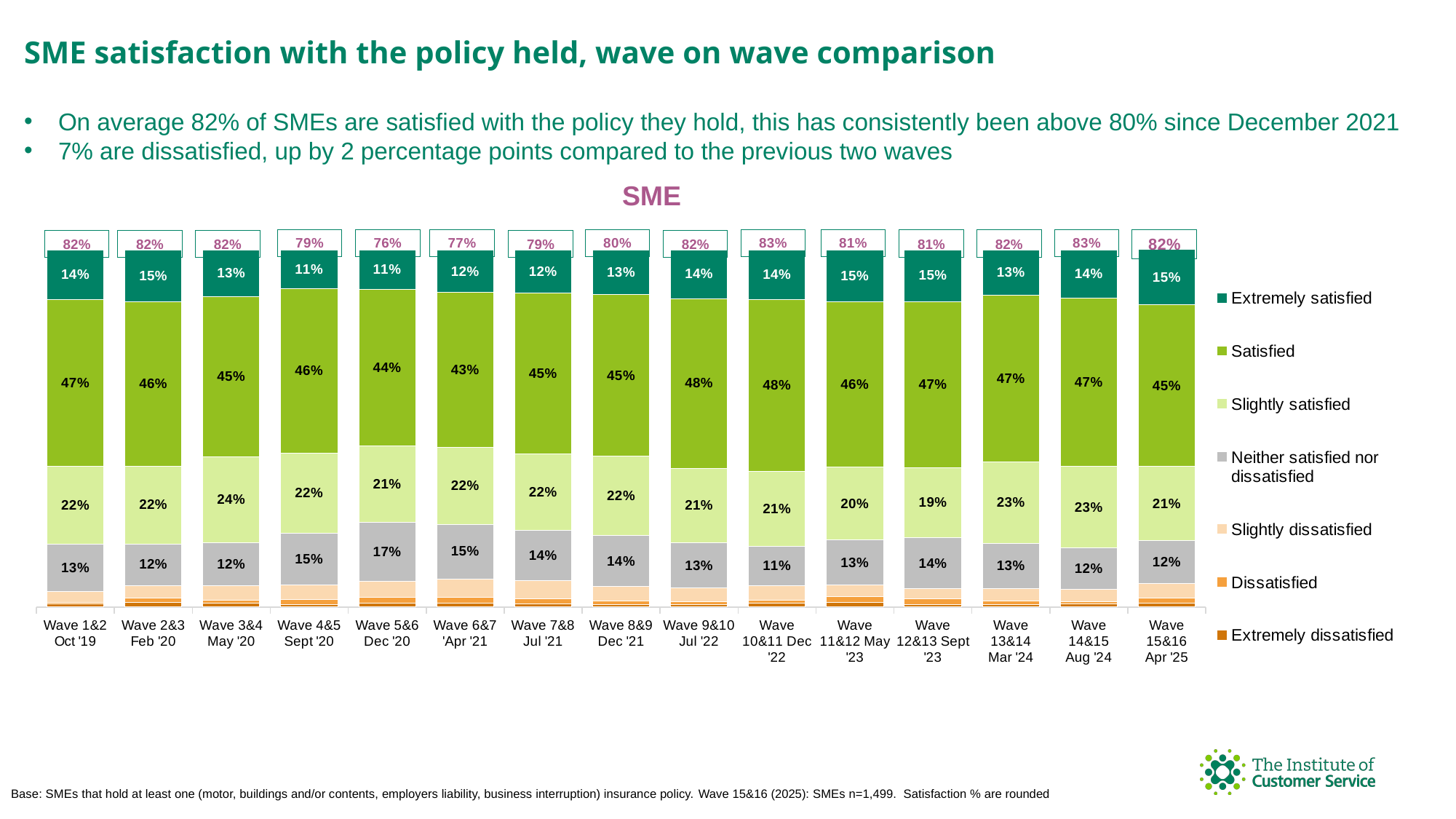
Which has the larger 'Extremely satisfied' value, Wave 2&3 Feb '20 or Wave 3&4 May '20? Wave 2&3 Feb '20 What kind of chart is shown on the slide? Stacked bar chart Which wave has the highest 'Neither satisfied nor dissatisfied' value? Wave 5&6 Dec '20 Which wave has the lowest overall satisfaction percentage shown in the boxes above the bars? Wave 5&6 Dec '20 What is the difference in the 'Satisfied' value between Wave 9&10 Jul '22 and Wave 6&7 'Apr '21? 5 percentage points What is the 'Extremely satisfied' value for Wave 1&2 Oct '19? 14% What percentage of SMEs were 'Satisfied' in Wave 9&10 Jul '22? 48% How many series does the legend list? 7 What overall satisfaction percentage is shown in the box above the bar for Wave 5&6 Dec '20? 76% What is the 'Neither satisfied nor dissatisfied' value for Wave 5&6 Dec '20? 17% How many waves are shown on the x axis of the chart? 15 Which wave has the lowest 'Satisfied' value? Wave 6&7 'Apr '21